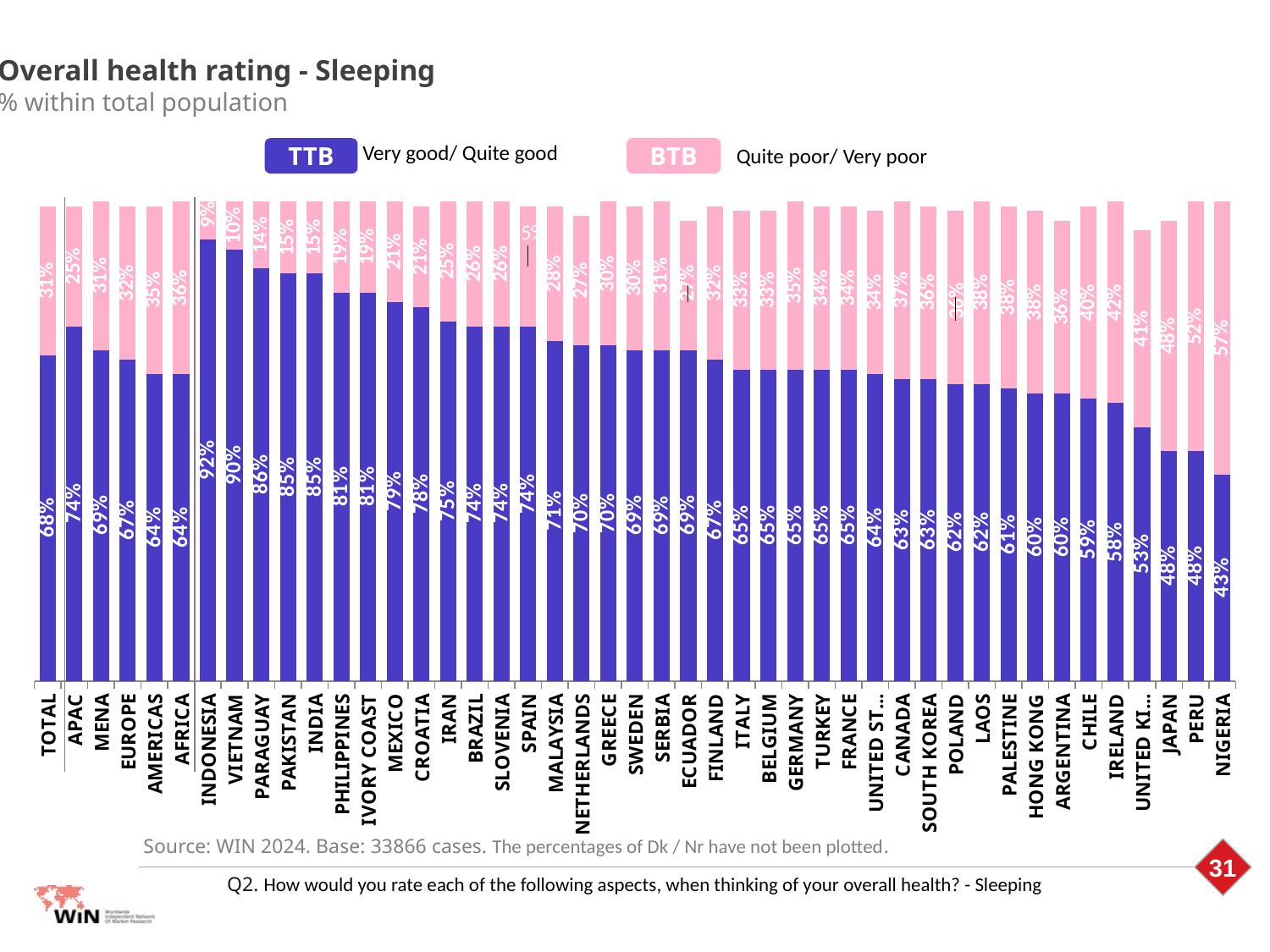
What does the BTB legend entry stand for? Quite poor/ Very poor Which category has the highest TTB (Very good/Quite good) value? Indonesia Which has a larger BTB value, Peru or Chile? Peru What is the difference between the TTB values for Vietnam and Japan? 42% What kind of chart is shown on the slide? Stacked bar chart Which category has the lowest TTB (Very good/Quite good) value? Nigeria What is the TTB value for TOTAL? 68% What is the TTB (Very good/Quite good) value for Indonesia? 92% Do the TTB values rise or fall moving from Indonesia to Nigeria along the x axis? Fall What is the BTB (Quite poor/Very poor) value for Nigeria? 57% What is the BTB value for Ireland? 42% How many series does the legend list? 2